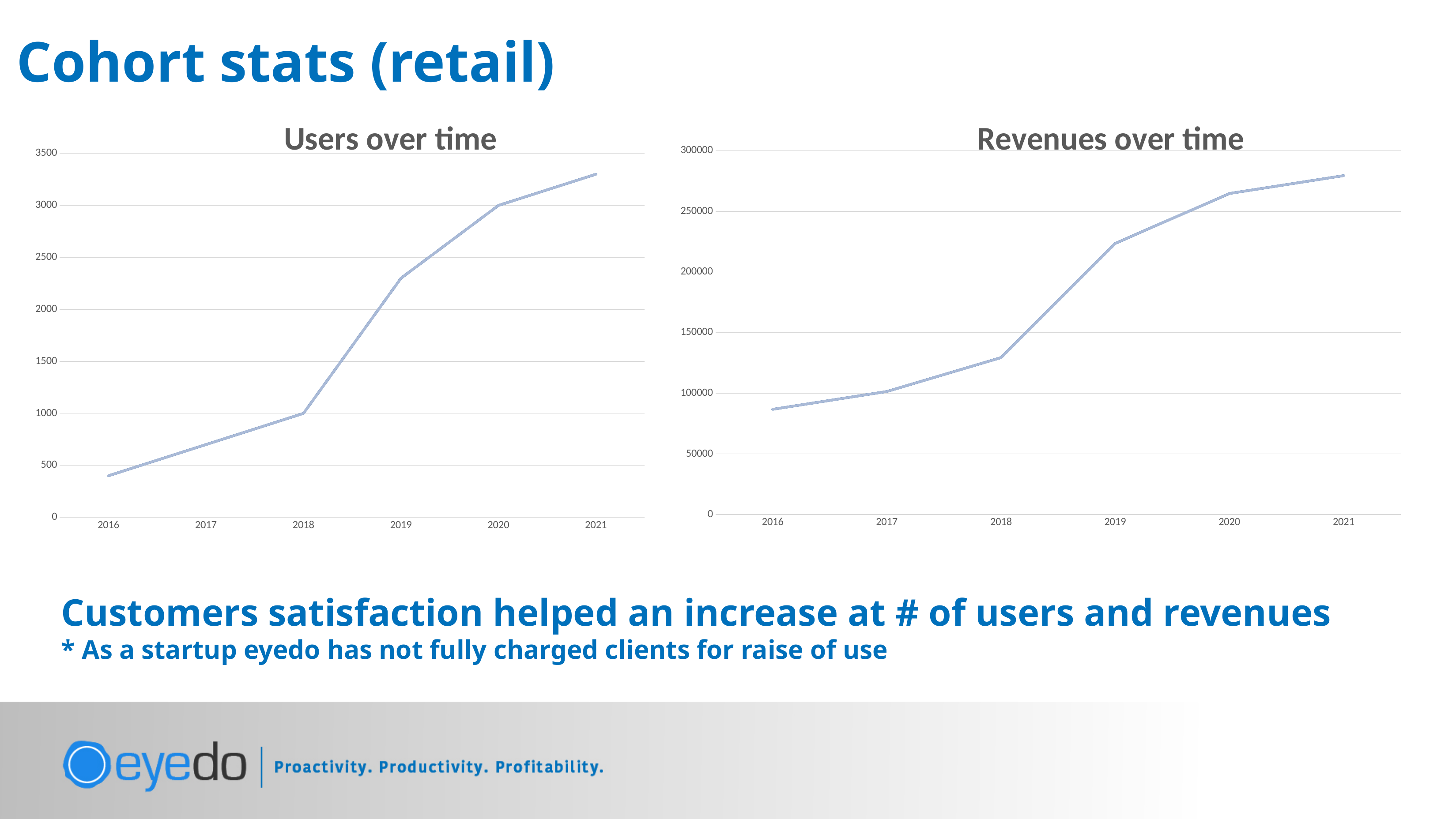
In the "Revenues over time" chart, is the value for 2018 greater or less than 150000? less What kind of chart is the "Revenues over time" chart? line chart In the "Users over time" chart, do the values rise or fall from 2016 to 2021? rise In the "Revenues over time" chart, which year has the lowest value? 2016 In the "Users over time" chart, is the value for 2019 greater or less than 2000? greater In the "Revenues over time" chart, how many years are plotted on the x axis? 6 In the "Users over time" chart, which year has the lowest value? 2016 In the "Revenues over time" chart, do the values rise or fall from 2016 to 2021? rise In the "Revenues over time" chart, is the value for 2020 greater or less than 250000? greater In the "Users over time" chart, how many years are plotted on the x axis? 6 In the "Users over time" chart, which year has the highest value? 2021 What kind of chart is the "Users over time" chart? line chart